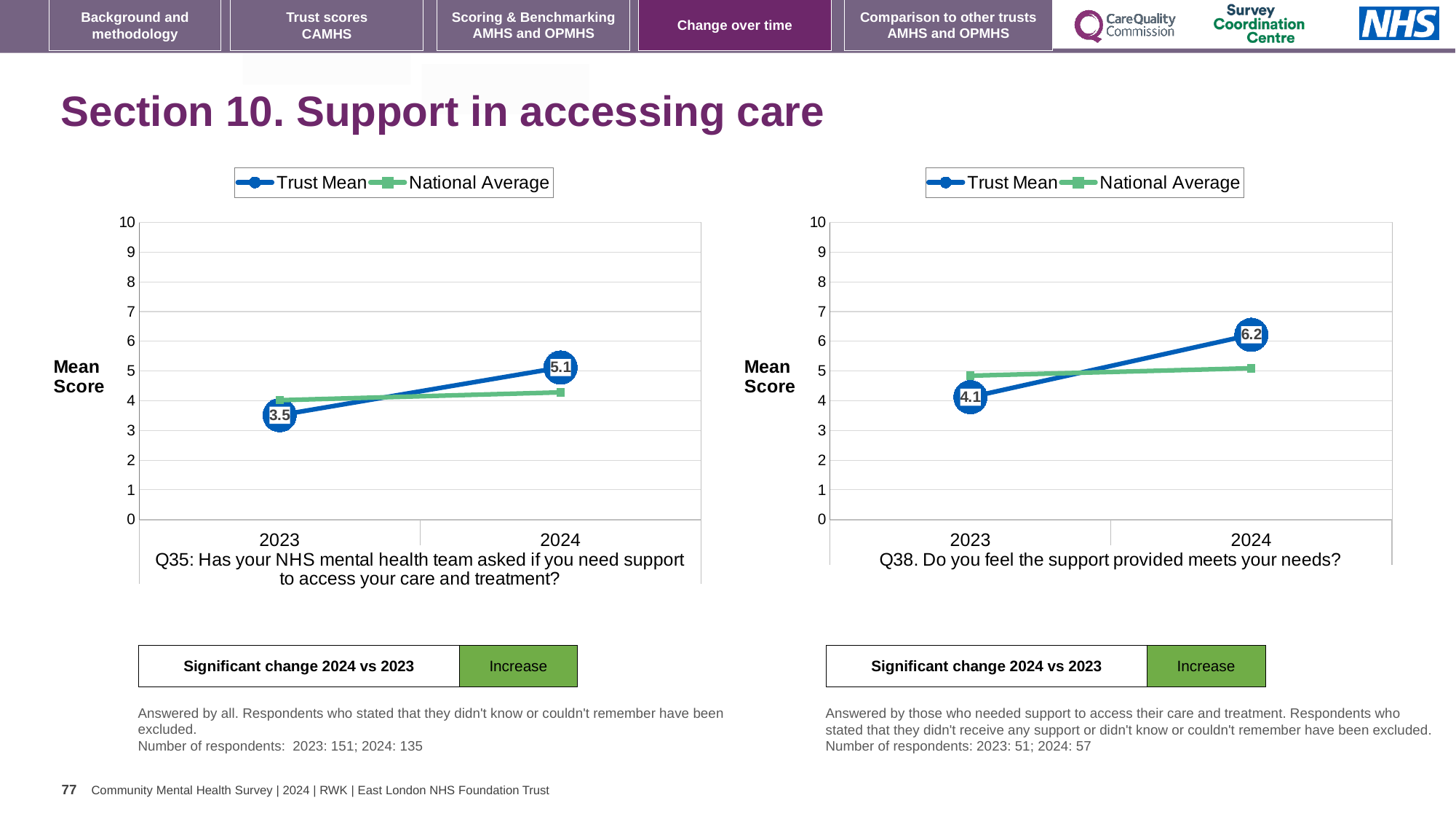
In the Q35 chart (left), what is the Trust Mean score for 2023? 3.5 In the Q38 chart (right), what is the Trust Mean score for 2023? 4.1 What type of chart is used for Q35 (left)? line chart In the Q35 chart (left), what is the Trust Mean score for 2024? 5.1 In the Q35 chart (left), is the National Average value for 2023 greater or less than 5? less In the Q38 chart (right), what is the Trust Mean score for 2024? 6.2 In the Q38 chart (right), by how much did the Trust Mean increase from 2023 to 2024? 2.1 How many series does the legend of the Q38 chart (right) list? 2 In the Q35 chart (left), by how much did the Trust Mean increase from 2023 to 2024? 1.6 How many years are plotted on the x axis of the Q35 chart (left)? 2 In the Q38 chart (right), which is larger in 2024: the Trust Mean or the National Average? Trust Mean In the Q38 chart (right), does the Trust Mean rise or fall from 2023 to 2024? rise